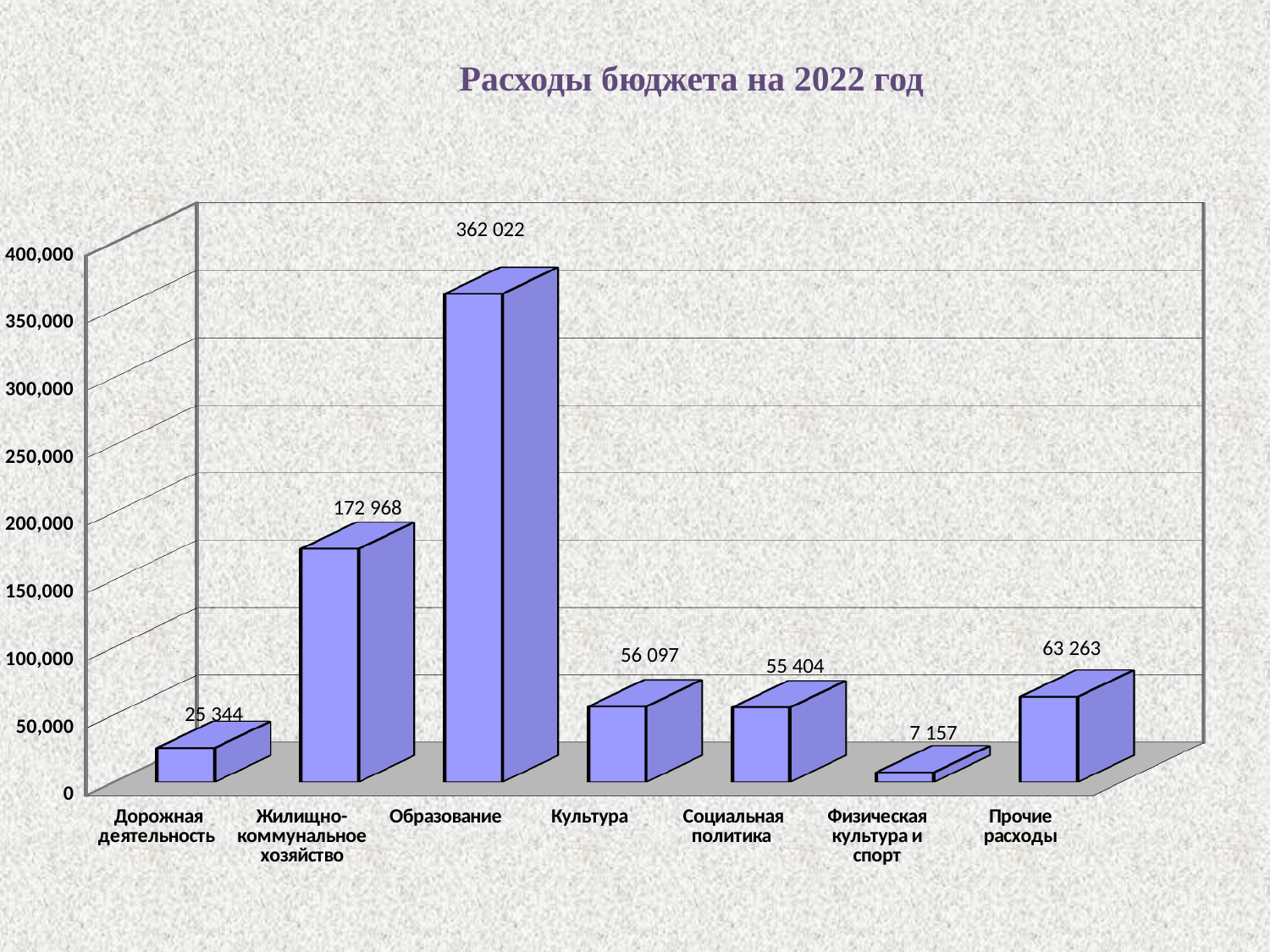
Which category has the highest value? Образование What is the difference between the values for Образование and Жилищно-коммунальное хозяйство? 189 054 What is the title of the chart? Расходы бюджета на 2022 год What is the value for Жилищно-коммунальное хозяйство? 172 968 Which is larger, the value for Прочие расходы or the value for Культура? Прочие расходы Is the value for Образование greater or less than 350,000? greater How many categories are shown on the chart? 7 What kind of chart is shown on the slide? bar chart Which category has the lowest value? Физическая культура и спорт What is the value for Прочие расходы? 63 263 What is the value for Образование? 362 022 What is the value for Физическая культура и спорт? 7 157